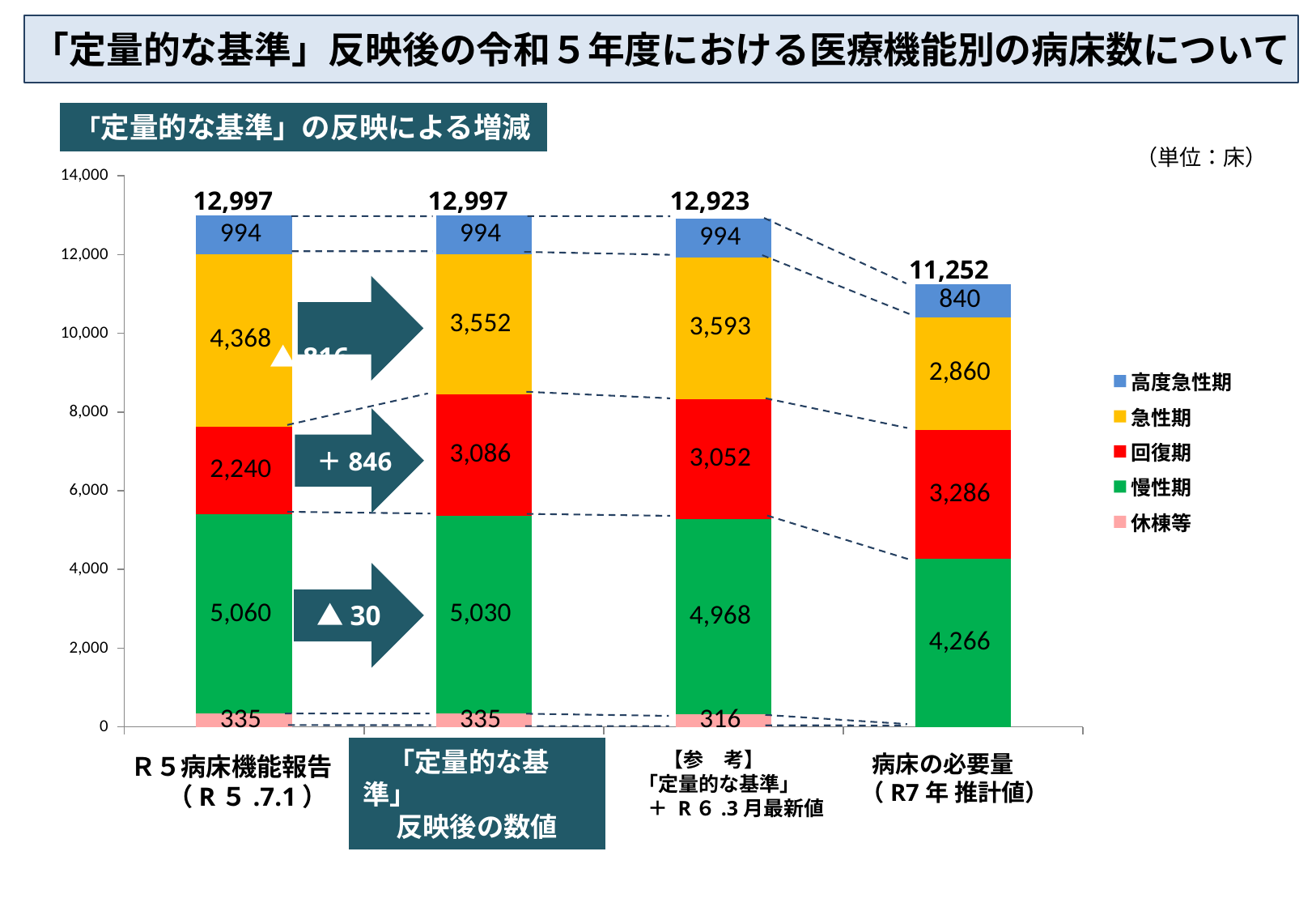
凡例にはいくつの系列が示されていますか？ 5 「病床の必要量（R7年推計値）」の棒の合計はいくつですか？ 11,252 「R５病床機能報告」と「定量的な基準」反映後の数値で、回復期の病床数の差はいくつですか？ 846 グラフには棒（カテゴリ）がいくつありますか？ 4 「R５病床機能報告（R５.7.1）」の急性期の病床数はいくつですか？ 4,368 このグラフはどの種類のグラフですか？ 積み上げ棒グラフ 「病床の必要量（R7年推計値）」の慢性期の病床数はいくつですか？ 4,266 「定量的な基準」反映後の数値における回復期の病床数はいくつですか？ 3,086 「定量的な基準」反映後の数値において、急性期と慢性期ではどちらの病床数が多いですか？ 慢性期 4つの棒のうち、合計が最も小さいのはどれですか？ 病床の必要量（R7年推計値） 凡例で回復期を表す色は何色ですか？ 赤 「【参考】「定量的な基準」＋R６.3月最新値」の休棟等の病床数はいくつですか？ 316